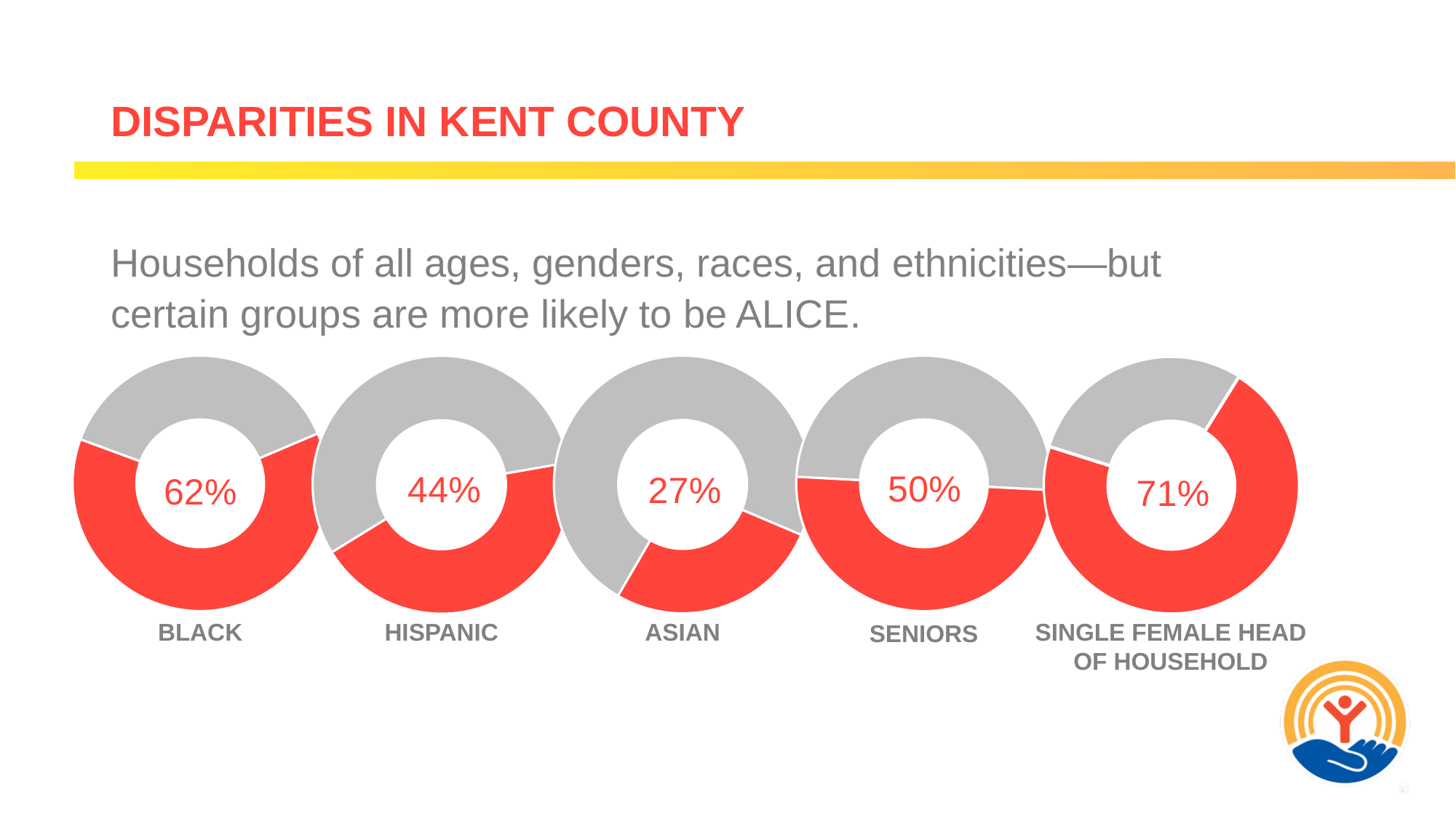
What colour is used for the highlighted percentage portion in each donut chart? Red Which group has the lowest percentage across the donut charts? ASIAN What percentage is shown in the BLACK donut chart? 62% What percentage is shown in the SENIORS donut chart? 50% Which is larger, the percentage for SENIORS or the percentage for HISPANIC? SENIORS What is the difference in percentage points between the BLACK and HISPANIC donut charts? 18 Which group has the highest percentage across the donut charts? SINGLE FEMALE HEAD OF HOUSEHOLD What percentage is shown in the ASIAN donut chart? 27% How many donut charts are shown on the slide? 5 What percentage is shown in the SINGLE FEMALE HEAD OF HOUSEHOLD donut chart? 71% What kind of chart is used to show each group's percentage? Donut (pie) chart What percentage is shown in the HISPANIC donut chart? 44%